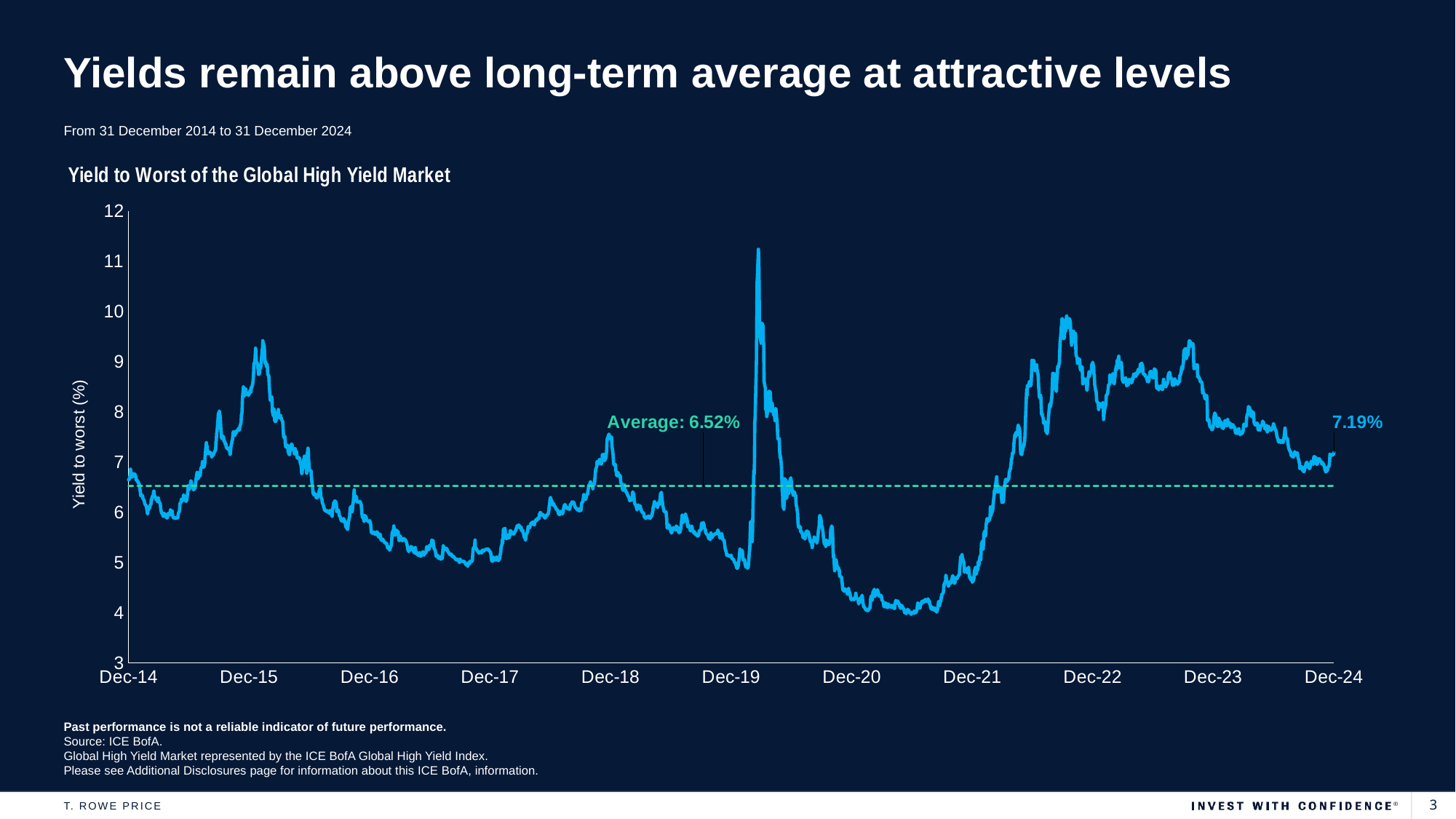
Does the yield to worst rise or fall between Dec-20 and Dec-22? rise What is the title of the chart? Yield to Worst of the Global High Yield Market Which is larger: the Dec-24 yield to worst or the long-term average? Dec-24 yield to worst (7.19%) What is the yield to worst value labelled at the end of the line at Dec-24? 7.19% Is the value of the line at Dec-15 greater or less than 7? greater Is the lowest point of the line, between Dec-20 and Dec-21, greater or less than 5? less How many date labels are shown on the x axis? 11 Does the yield to worst rise or fall between Dec-22 and Dec-24? fall Is the peak of the line shortly after Dec-19 greater or less than 10? greater By how much does the Dec-24 value of 7.19% exceed the average of 6.52%? 0.67% What kind of chart is shown on the slide? line chart What is the long-term average yield to worst shown by the dashed line? 6.52%